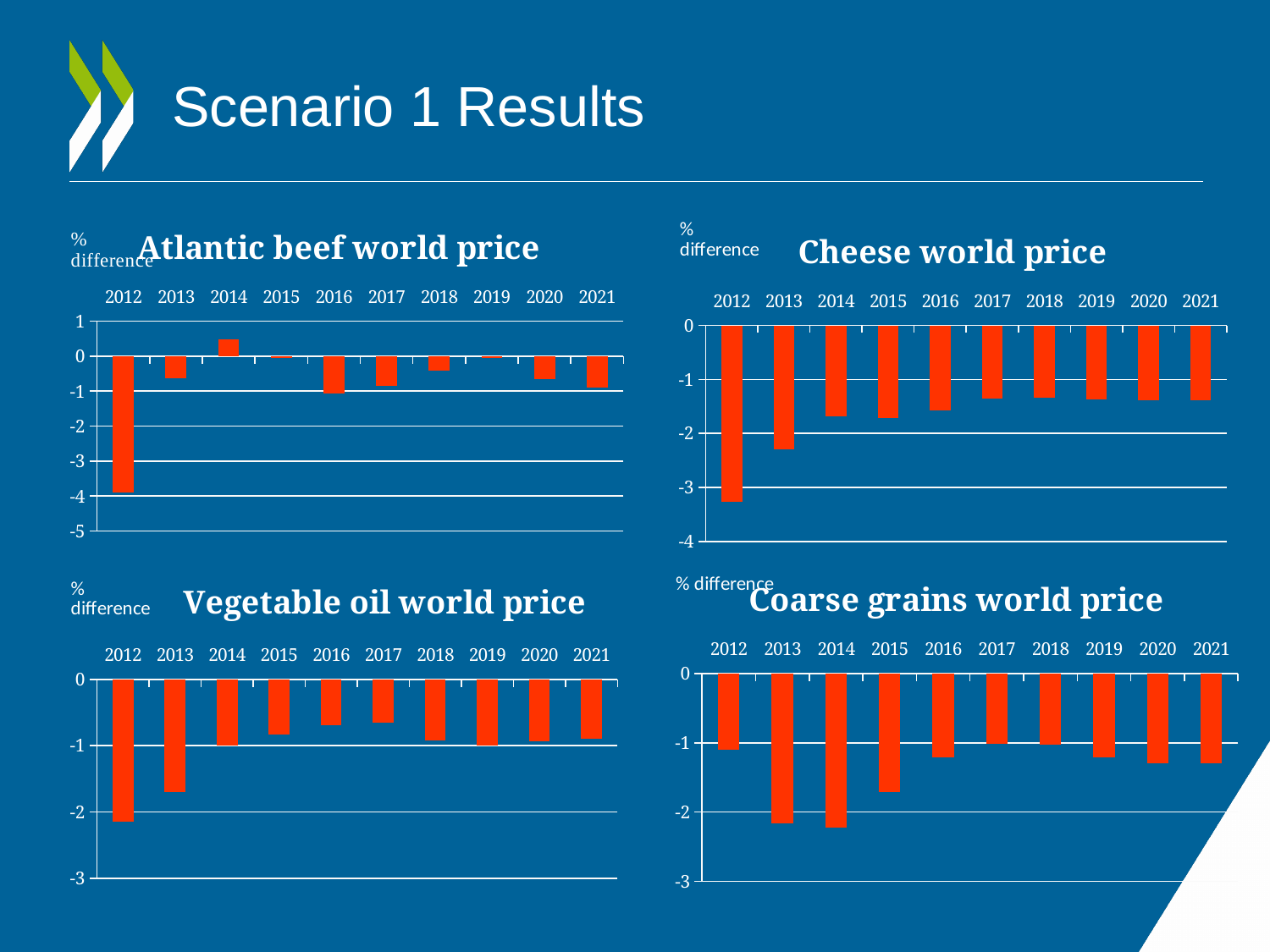
In the Cheese world price chart, which year has the lowest value? 2012 In the Cheese world price chart, how many years are plotted on the x axis? 10 What label is shown on the vertical axis of the Vegetable oil world price chart? % difference How many charts are shown on the slide? 4 What kind of chart is the Atlantic beef world price chart? bar chart In the Atlantic beef world price chart, which year has the highest value? 2014 In the Cheese world price chart, is the value for 2012 greater or less than -3? less In the Atlantic beef world price chart, which year has the lowest value? 2012 In the Vegetable oil world price chart, is the value for 2013 greater or less than -1? less In the Coarse grains world price chart, is the value for 2014 greater or less than -2? less In the Vegetable oil world price chart, which year has the lowest value? 2012 In the Coarse grains world price chart, which year has the larger value, 2015 or 2016? 2016